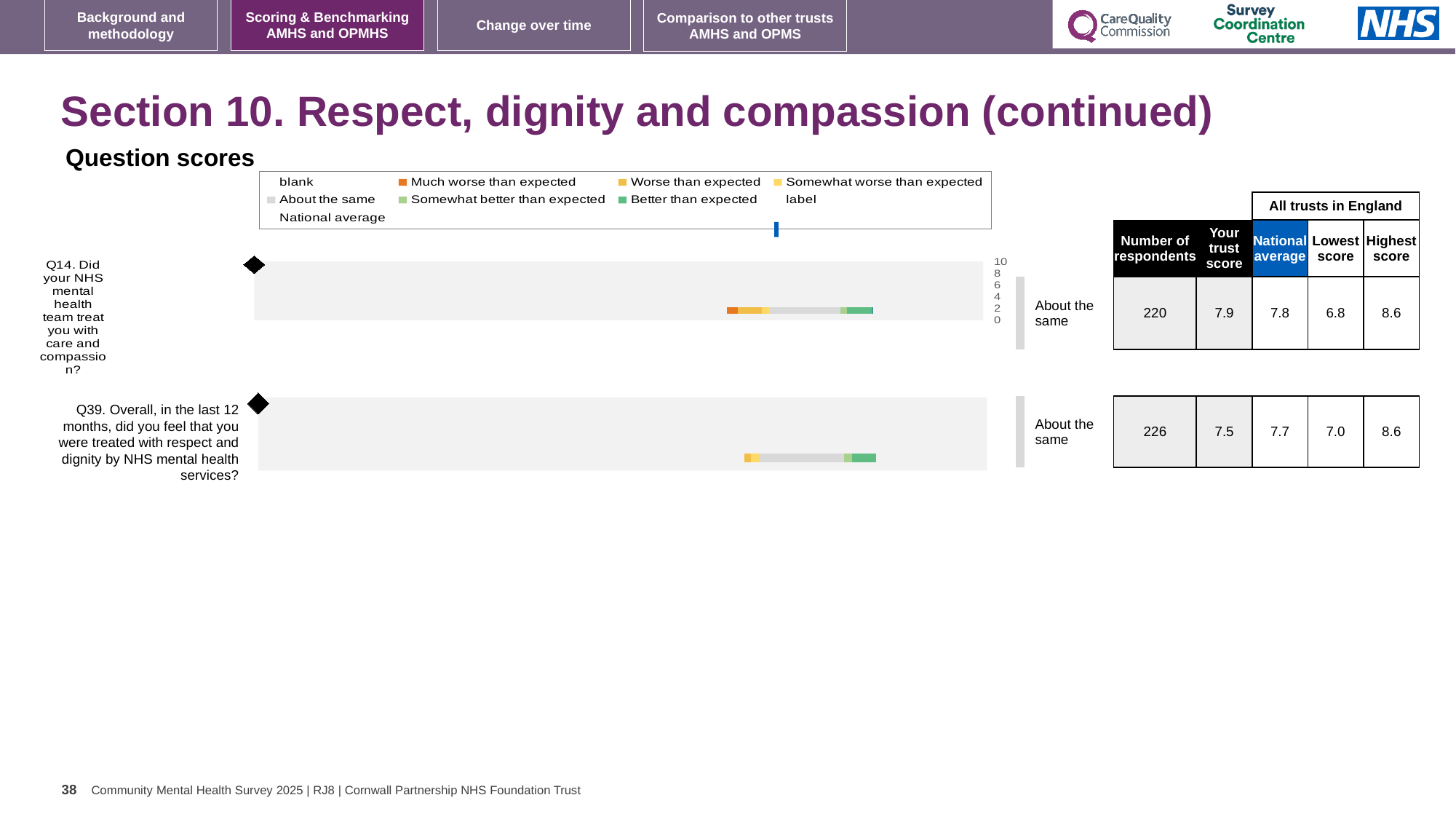
How many questions are plotted in the chart? 2 What is the difference between the highest and lowest scores for Q39? 1.6 What is the trust score for Q14 (care and compassion)? 7.9 What is the trust score for Q39 (treated with respect and dignity)? 7.5 What is the highest score among all trusts in England for Q14? 8.6 What benchmark category is shown for Q39? About the same By how much does the trust score for Q14 exceed the national average for Q14? 0.1 How many respondents answered Q39? 226 What is the lowest score among all trusts in England for Q39? 7.0 Which question has the higher trust score, Q14 or Q39? Q14 What is the national average score for Q14? 7.8 How many respondents answered Q14? 220